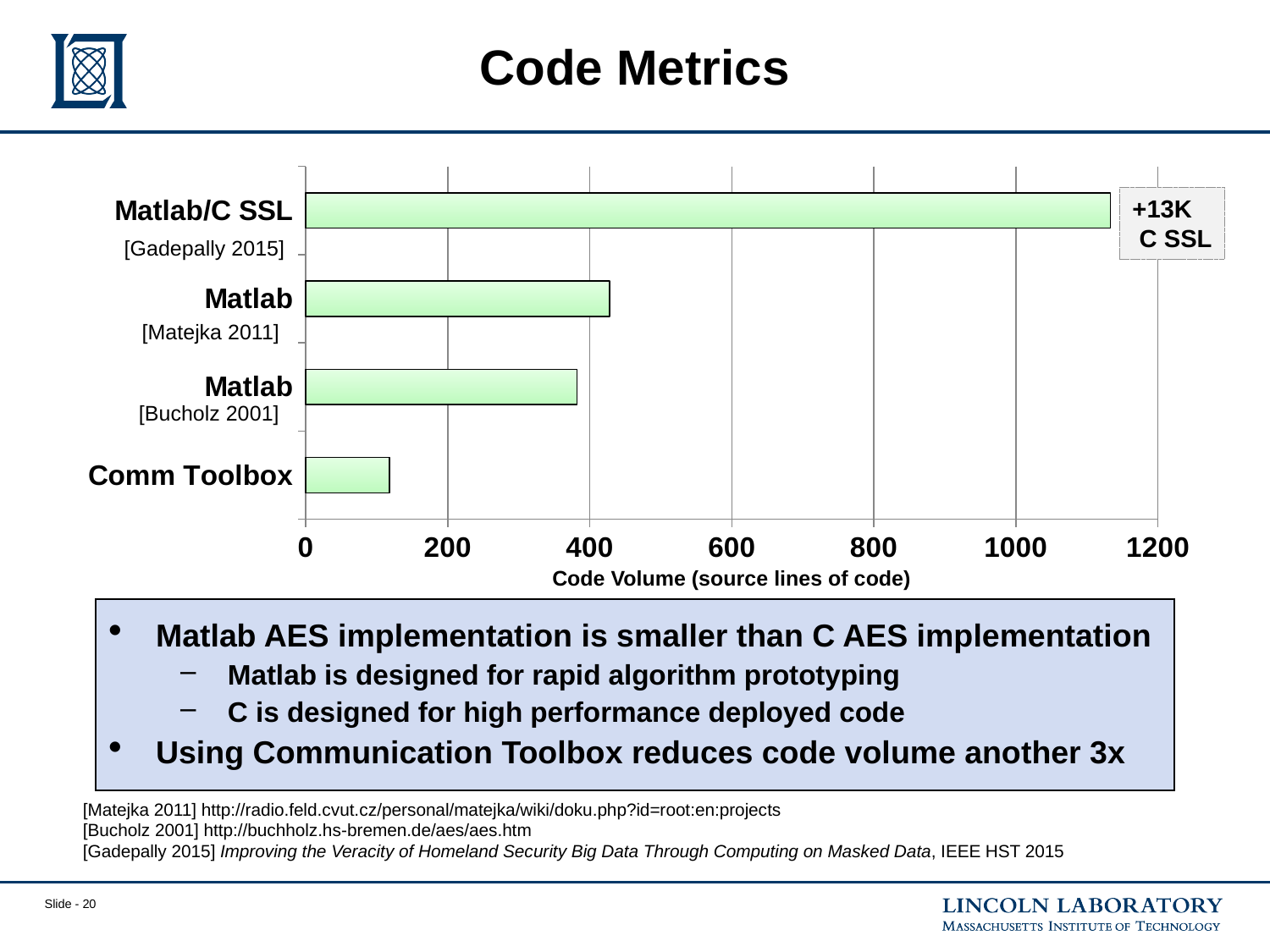
What does the annotation box next to the Matlab/C SSL bar say? +13K C SSL Is the code volume for Matlab/C SSL [Gadepally 2015] greater or less than 1000? greater What kind of chart is shown on the slide? bar chart Is the code volume for Matlab [Matejka 2011] greater or less than 400? greater Which category has the lowest code volume? Comm Toolbox What is the label of the horizontal axis of the chart? Code Volume (source lines of code) Is the code volume for Comm Toolbox greater or less than 200? less Which has a larger code volume, Matlab [Matejka 2011] or Comm Toolbox? Matlab [Matejka 2011] Which category has the highest code volume? Matlab/C SSL [Gadepally 2015] How many categories are plotted in the chart? 4